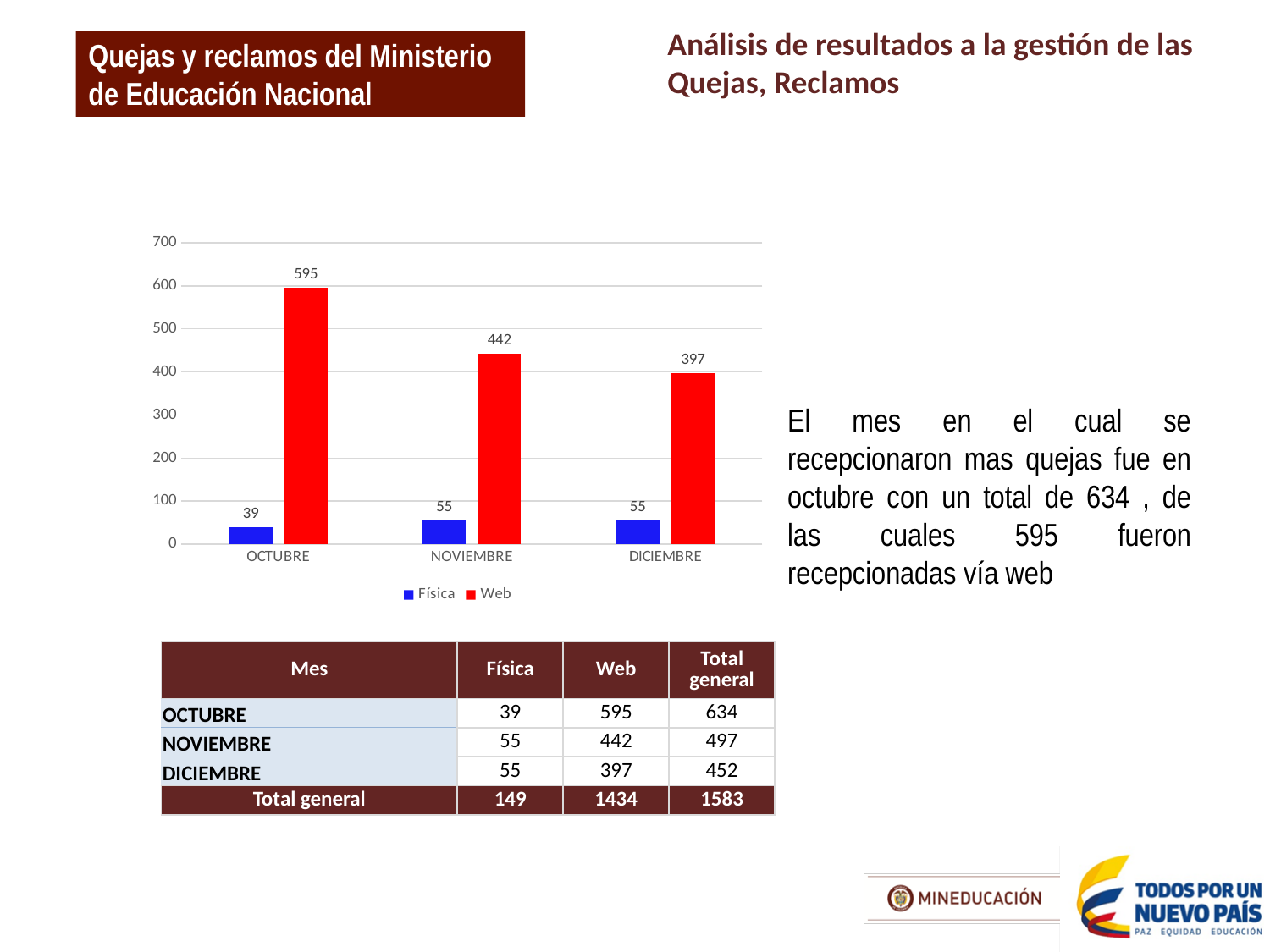
Which month has the lowest Física value? OCTUBRE What is the Web value for DICIEMBRE? 397 Which month has the highest Web value? OCTUBRE How many months are shown on the x axis of the chart? 3 Which is larger, the Web value for NOVIEMBRE or the Web value for DICIEMBRE? NOVIEMBRE What is the difference between the Web values for OCTUBRE and NOVIEMBRE? 153 How many series does the chart legend list? 2 Is the Web value for DICIEMBRE greater or less than 400? less What kind of chart is shown on the slide? bar chart Do the Web values rise or fall from OCTUBRE to DICIEMBRE? fall What is the Web value for OCTUBRE? 595 What is the Física value for NOVIEMBRE? 55